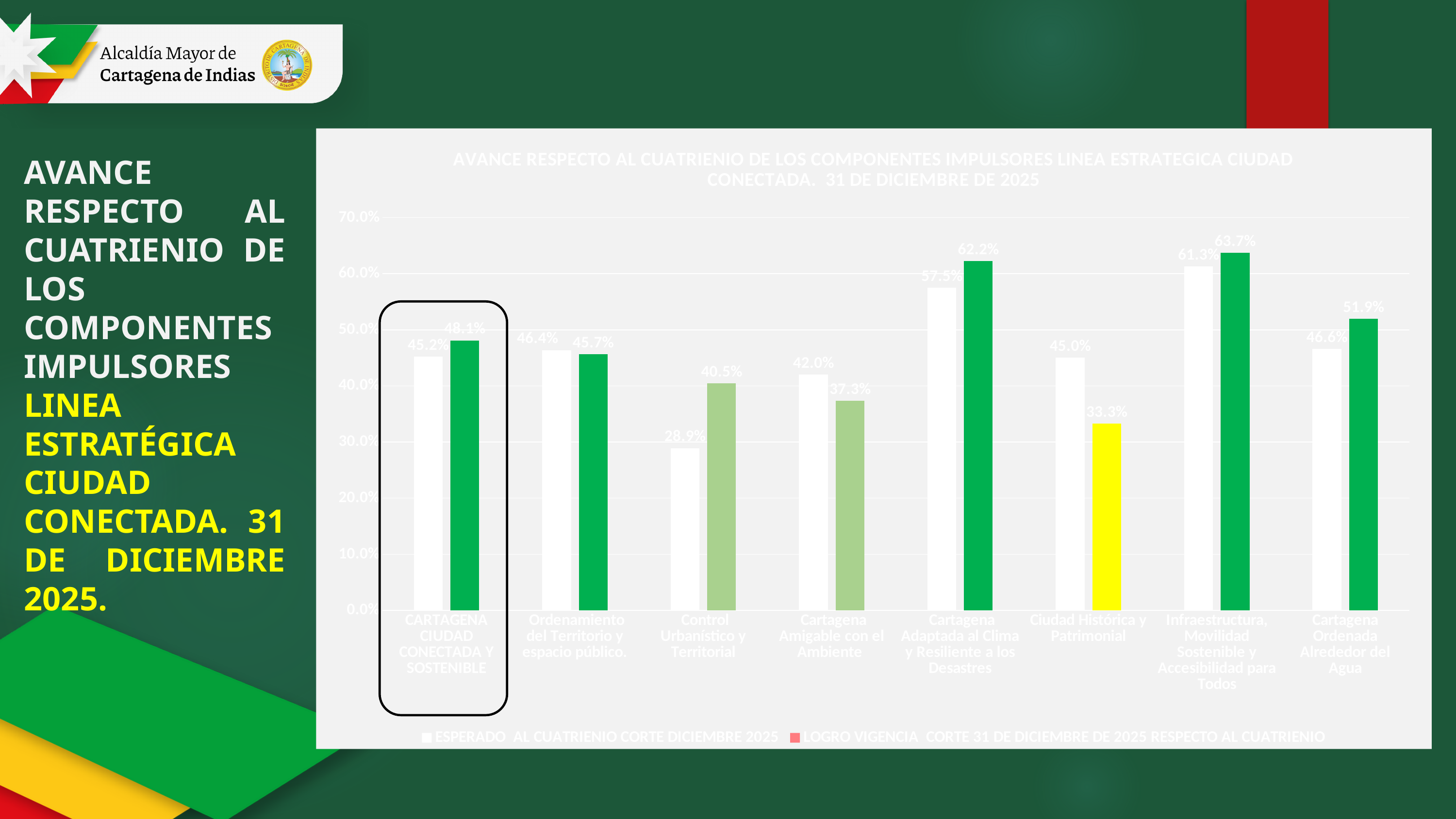
What is the ESPERADO AL CUATRIENIO value for Cartagena Adaptada al Clima y Resiliente a los Desastres? 57.5% How many series does the chart legend list? 2 Which category has the lowest ESPERADO AL CUATRIENIO value? Control Urbanístico y Territorial Which category has the highest LOGRO VIGENCIA value? Infraestructura, Movilidad Sostenible y Accesibilidad para Todos Which category is highlighted with a black rounded outline on the chart? CARTAGENA CIUDAD CONECTADA Y SOSTENIBLE What is the LOGRO VIGENCIA value for Control Urbanístico y Territorial? 40.5% What is the LOGRO VIGENCIA value for Ciudad Histórica y Patrimonial? 33.3% What kind of chart is shown on the slide? Bar chart Is the LOGRO VIGENCIA value for Cartagena Adaptada al Clima y Resiliente a los Desastres greater or less than 60.0%? greater What is the difference between the LOGRO VIGENCIA and ESPERADO values for Cartagena Ordenada Alrededor del Agua? 5.3% How many categories are shown on the x axis of the chart? 8 For Cartagena Amigable con el Ambiente, which is larger: the ESPERADO value or the LOGRO VIGENCIA value? ESPERADO (42.0%)